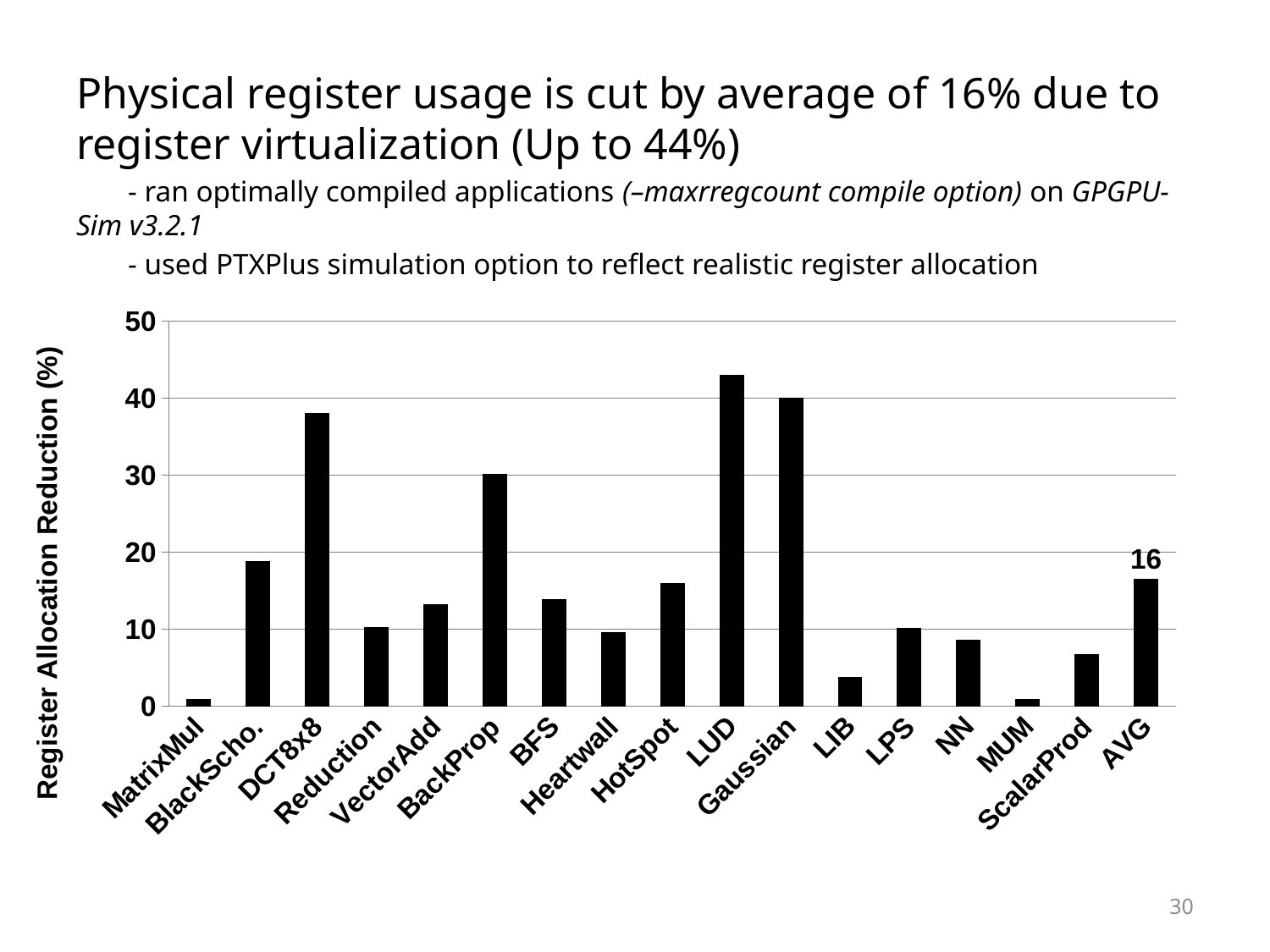
What is the label of the y axis? Register Allocation Reduction (%) Is the value for DCT8x8 greater or less than 30? greater Is the value for LIB greater or less than 10? less Which category has the highest Register Allocation Reduction? LUD What is the value for AVG? 16 Which is larger, the value for BFS or the value for Heartwall? BFS Is the value for HotSpot greater or less than 10? greater What kind of chart is shown on the slide? bar chart How many categories are plotted on the x axis? 17 Which is larger, the value for DCT8x8 or the value for BackProp? DCT8x8 Which is larger, the value for LUD or the value for Gaussian? LUD